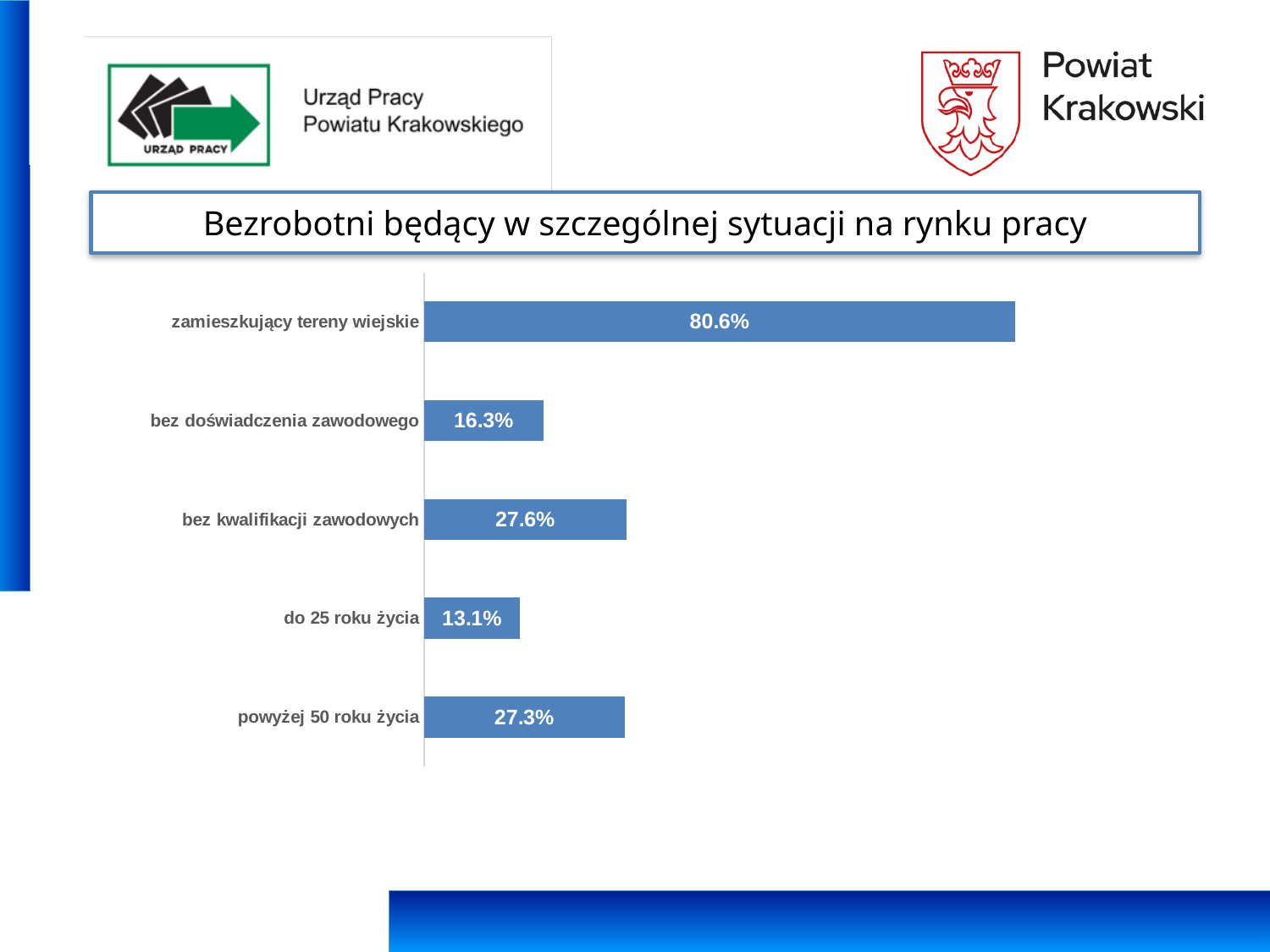
What is the value for "bez doświadczenia zawodowego"? 16.3% What is the difference between the values for "bez doświadczenia zawodowego" and "do 25 roku życia"? 3.2% Which is larger, the value for "bez kwalifikacji zawodowych" or the value for "bez doświadczenia zawodowego"? bez kwalifikacji zawodowych What is the value for "powyżej 50 roku życia"? 27.3% What is the value for "do 25 roku życia"? 13.1% Which category has the highest value? zamieszkujący tereny wiejskie How many categories are shown in the chart? 5 What is the title shown above the chart? Bezrobotni będący w szczególnej sytuacji na rynku pracy What kind of chart is shown on the slide? bar chart What is the difference between the values for "zamieszkujący tereny wiejskie" and "bez kwalifikacji zawodowych"? 53.0% What is the value for "zamieszkujący tereny wiejskie"? 80.6% Which category has the lowest value? do 25 roku życia